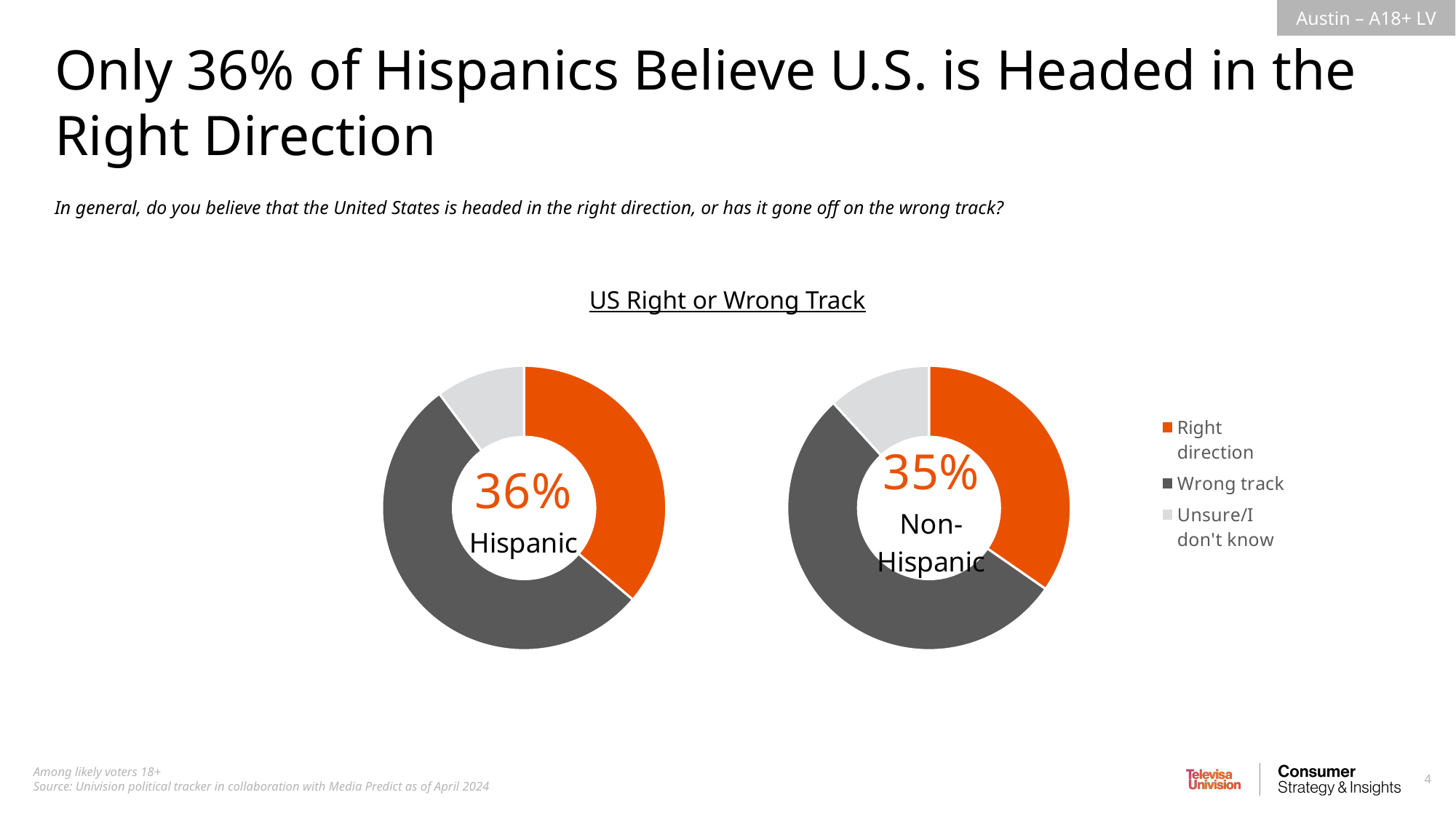
How many response categories does the legend list for the US Right or Wrong Track charts? 3 In the Non-Hispanic donut chart, which response category has the smallest slice? Unsure/I don't know In the Hispanic donut chart, which response category has the largest slice? Wrong track In the Non-Hispanic donut chart, which response category has the largest slice? Wrong track What colour represents 'Wrong track' in the donut charts? Dark grey In the Hispanic donut chart, what percentage believe the U.S. is headed in the right direction? 36% Which group has the higher 'Right direction' share, Hispanic or Non-Hispanic? Hispanic In the Non-Hispanic donut chart, what percentage believe the U.S. is headed in the right direction? 35% What is the difference between the Hispanic and Non-Hispanic 'Right direction' percentages? 1 percentage point What type of chart is used to show the US Right or Wrong Track results? Pie (donut) chart How many donut charts are shown on the slide? 2 In the Hispanic donut chart, which response category has the smallest slice? Unsure/I don't know